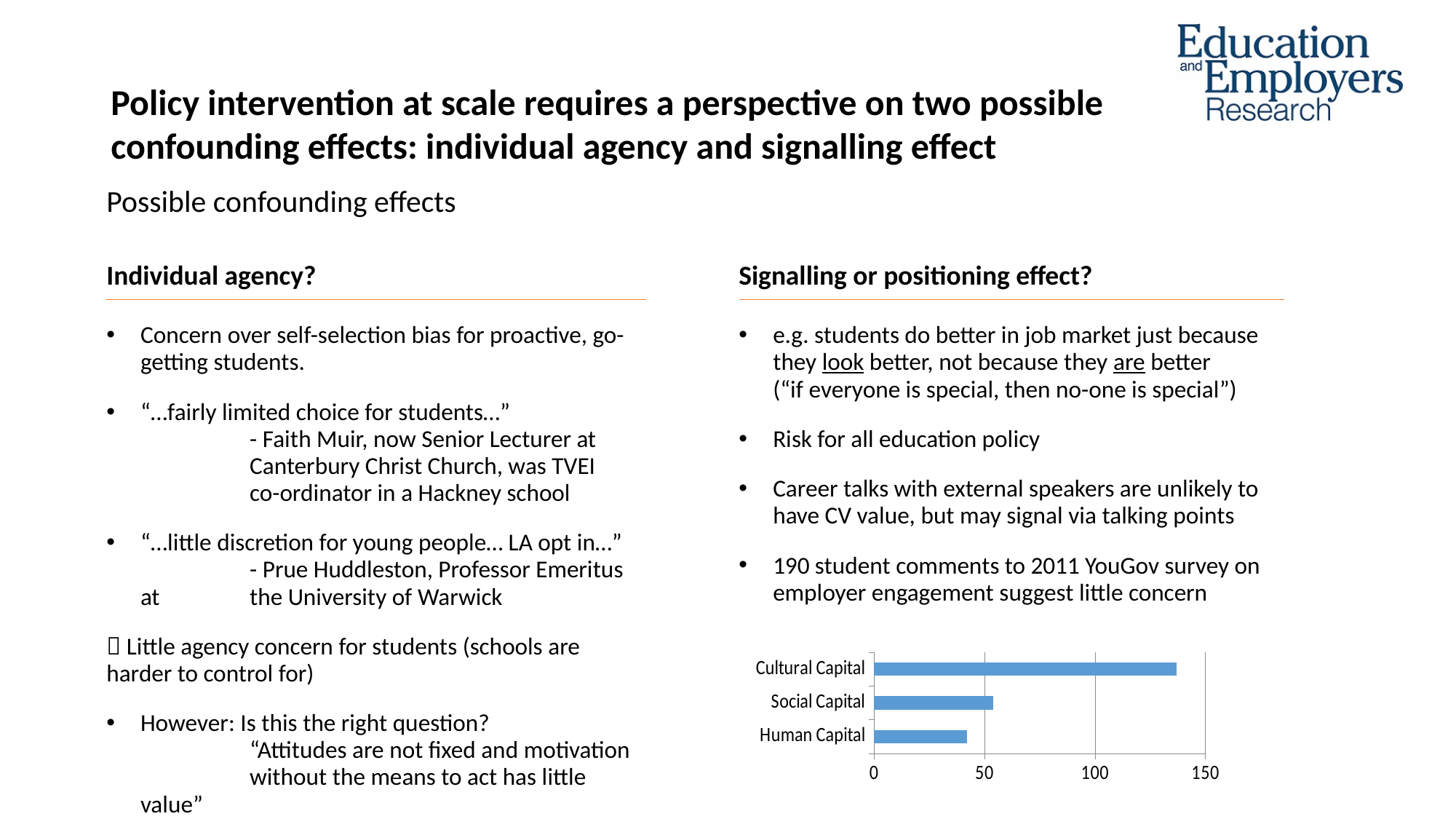
Is the value for Human Capital greater or less than 50? less How many categories does the bar chart show? 3 Which is larger in the bar chart, Social Capital or Human Capital? Social Capital What is the highest tick value shown on the horizontal axis of the bar chart? 150 What colour are the bars in the bar chart? blue Is the value for Cultural Capital greater or less than 100? greater Which is larger in the bar chart, Cultural Capital or Social Capital? Cultural Capital Which category has the highest value in the bar chart? Cultural Capital Is the value for Social Capital greater or less than 100? less What kind of chart is shown on the slide? bar chart Which category has the lowest value in the bar chart? Human Capital